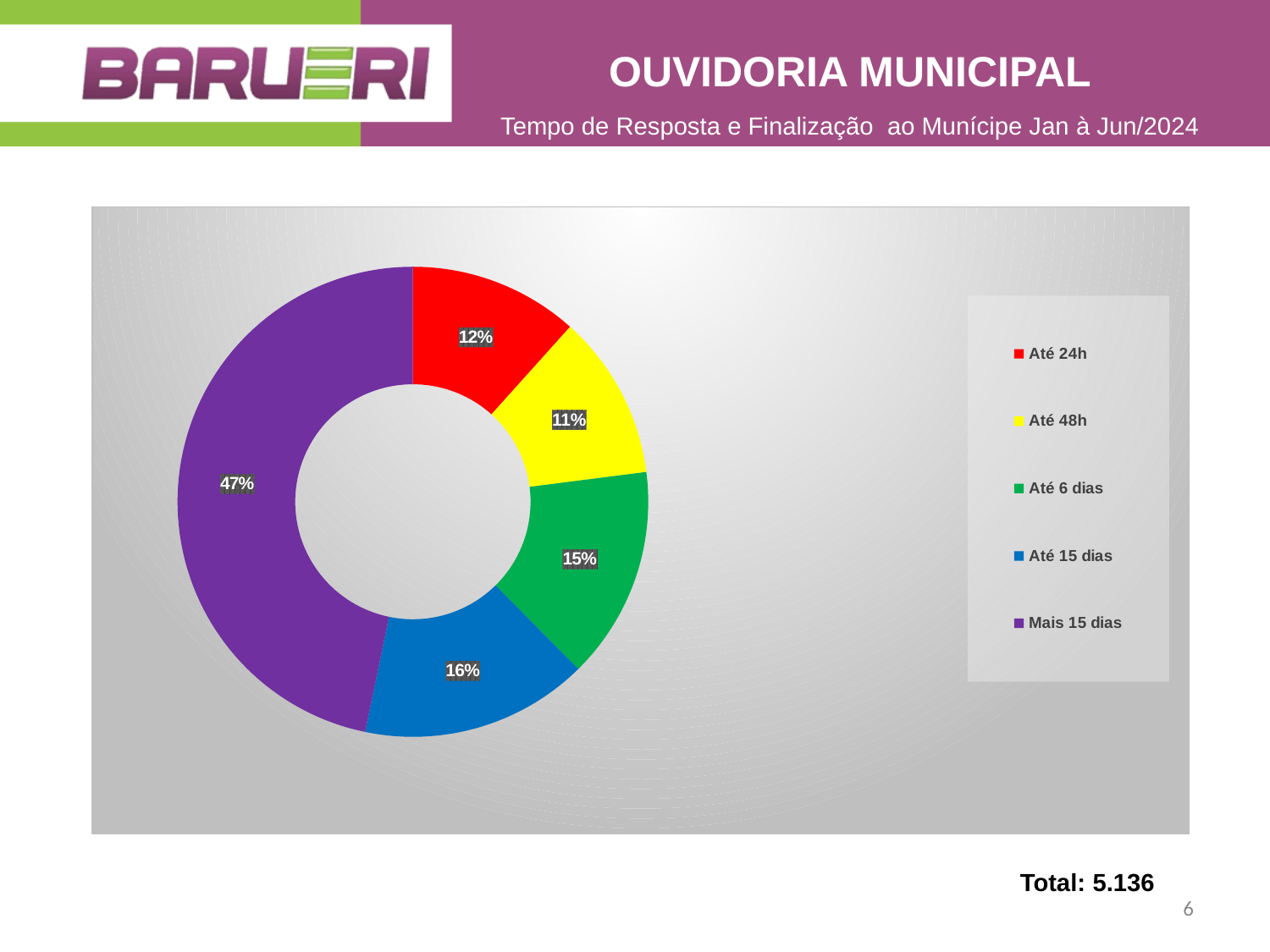
What share of the chart does "Mais 15 dias" represent? 47% Which category has the smallest share of the chart? Até 48h What is the difference in percentage points between "Mais 15 dias" and "Até 15 dias"? 31 percentage points Which colour represents "Até 15 dias" in the chart? Blue What kind of chart is shown on the slide? Doughnut (pie) chart How many categories does the chart show? 5 What is the value shown for "Até 24h"? 12% What is the value shown for "Até 6 dias"? 15% What is the value shown for "Até 48h"? 11% What is the value shown for "Até 15 dias"? 16% Which category has the largest share of the chart? Mais 15 dias Which is larger, the share for "Até 6 dias" or the share for "Até 24h"? Até 6 dias